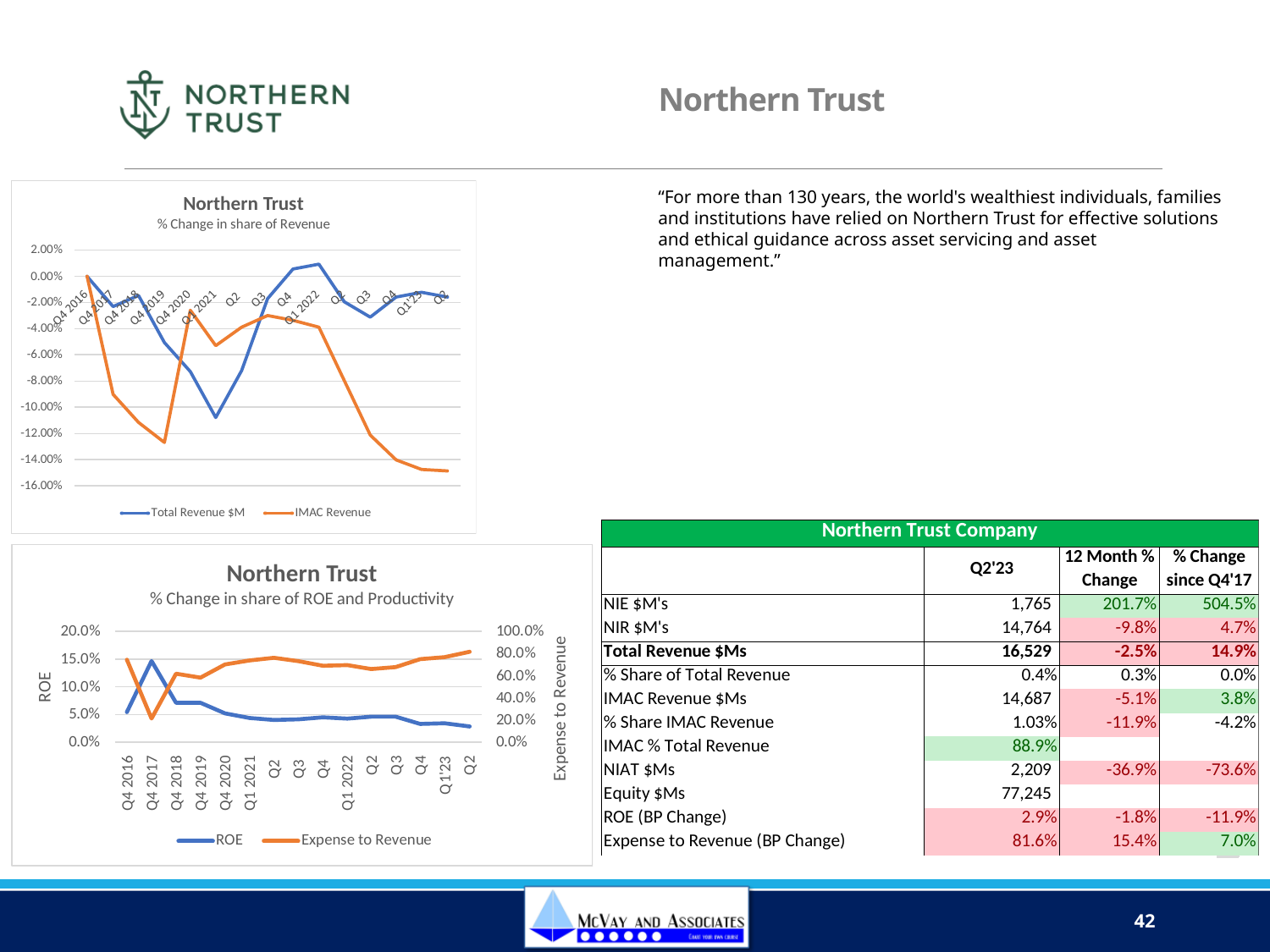
In the bottom chart (% Change in share of ROE and Productivity), does the ROE line generally rise or fall from Q4 2017 to the final Q2 point? fall What are the two series named in the legend of the top chart (% Change in share of Revenue)? Total Revenue $M and IMAC Revenue In the top chart (% Change in share of Revenue), does the IMAC Revenue line rise or fall from Q1 2022 to the final Q2 point? fall In the top chart (% Change in share of Revenue), is the Total Revenue $M value at Q1 2022 greater or less than 0.00%? greater In the top chart (% Change in share of Revenue), which series has the higher value at Q4 2018, Total Revenue $M or IMAC Revenue? Total Revenue $M In the bottom chart (% Change in share of ROE and Productivity), is the Expense to Revenue value at the final Q2 point greater or less than 60.0%? greater In the top chart (% Change in share of Revenue), is the IMAC Revenue value at Q4 2018 greater or less than -10.00%? less What kind of chart is the bottom chart titled 'Northern Trust % Change in share of ROE and Productivity'? line chart How many series does the legend of the bottom chart (% Change in share of ROE and Productivity) list? 2 What kind of chart is the top chart titled 'Northern Trust % Change in share of Revenue'? line chart How many series does the legend of the top chart (% Change in share of Revenue) list? 2